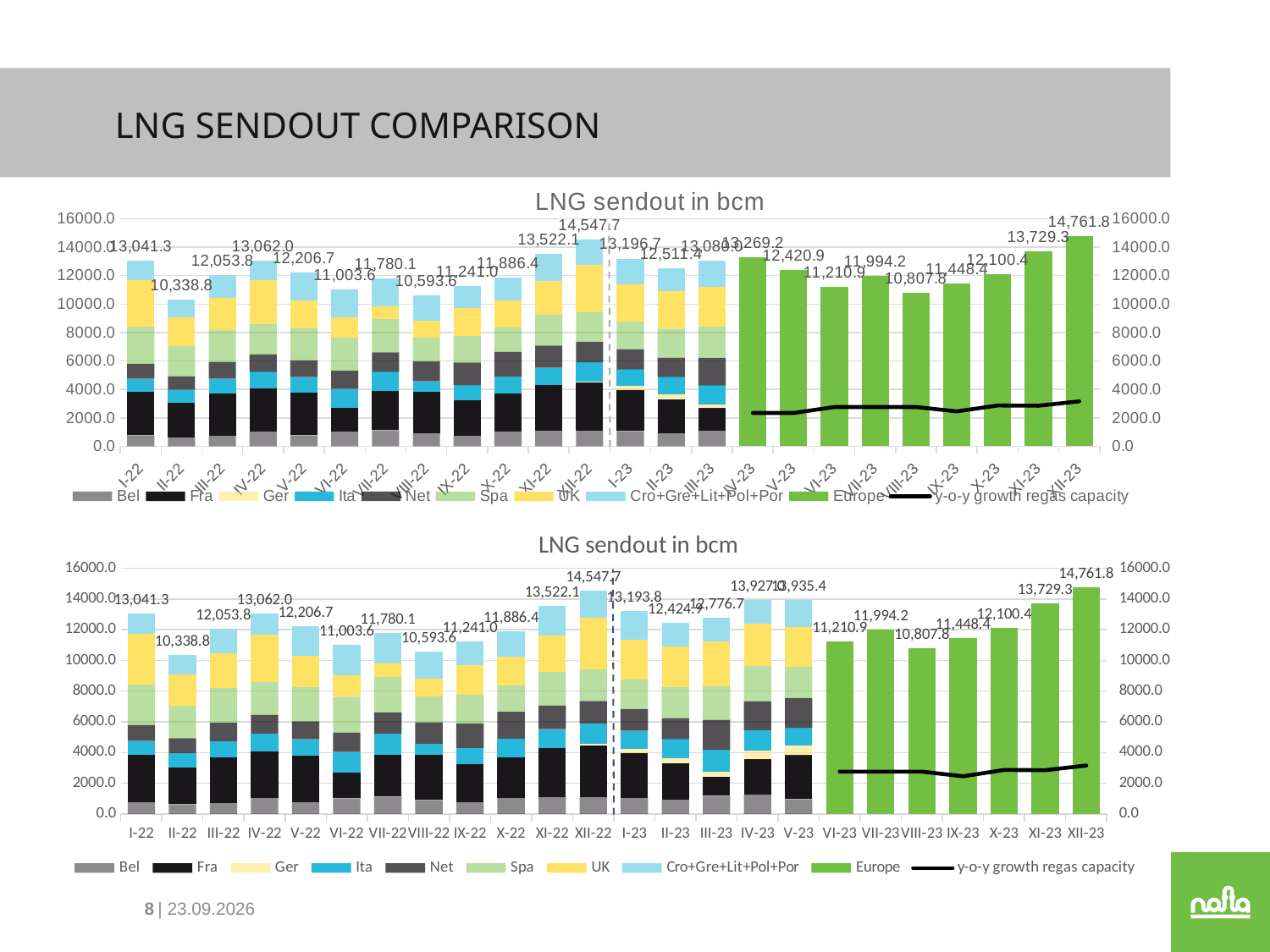
In the bottom chart, what is the value labelled for IV-23? 13,927.0 In the top chart, do the green Europe bars rise or fall from VIII-23 to XII-23? rise In the top chart, which month has the lowest labelled LNG sendout? II-22 In the bottom chart, which is larger, the value for I-22 or the value for II-22? I-22 In the top chart, what is the value labelled for II-22? 10,338.8 How many months are shown on the x axis of the bottom chart? 24 In the bottom chart, what is the value labelled for I-23? 13,193.8 In the top chart, which month has the highest labelled LNG sendout? XII-23 How many entries does the legend of the bottom chart list? 10 In the top chart, what is the difference between the labelled values for XII-23 and XII-22? 214.1 In the top chart, what is the LNG sendout value labelled for XII-23? 14,761.8 In the top chart, is the y-o-y growth regas capacity line at XII-23 greater or less than 4000.0? less